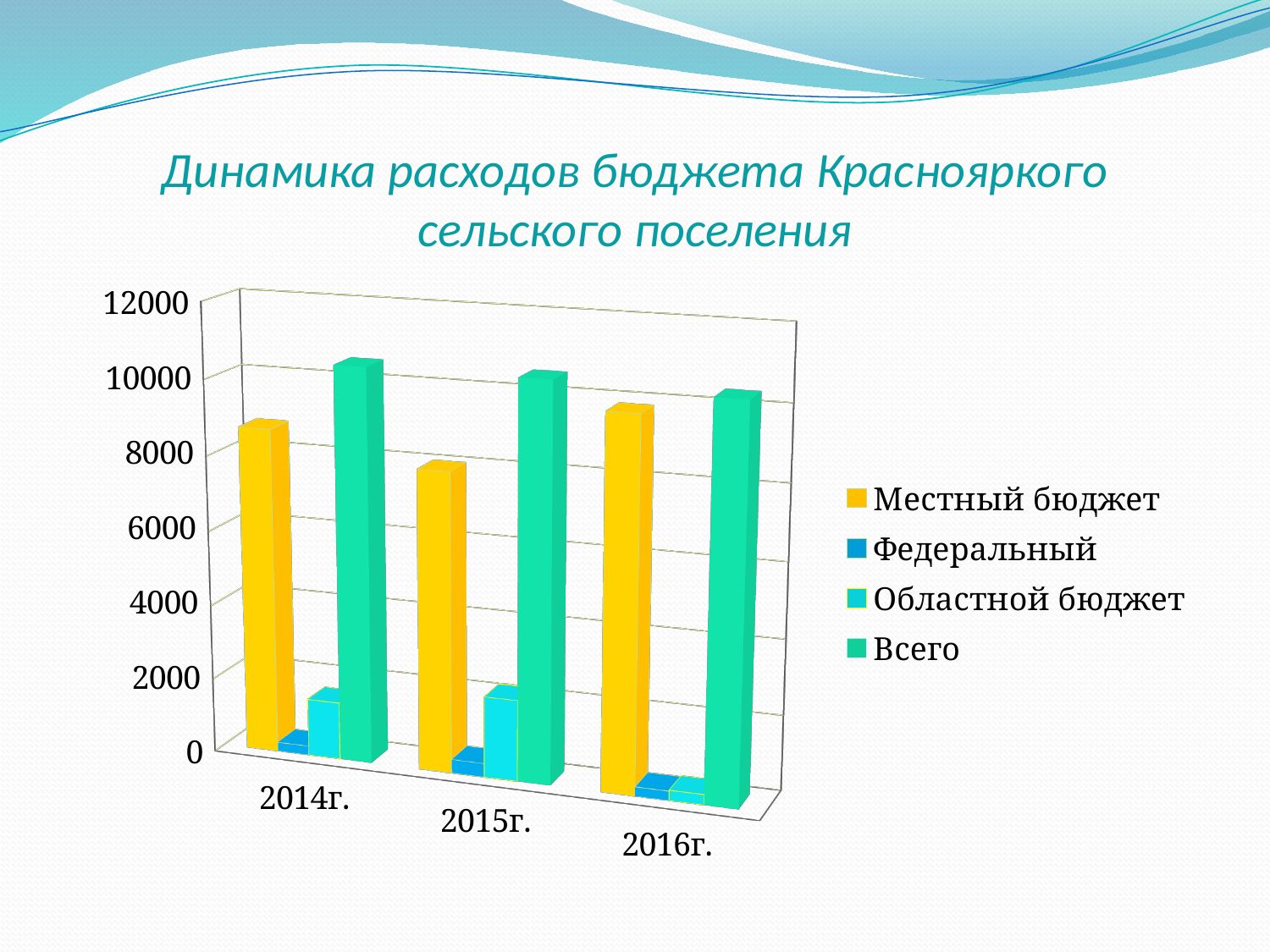
Which year has the lowest value for Всего? 2016г. Is the value for Местный бюджет in 2015г. greater or less than 10000? less Is the value for Всего in 2014г. greater or less than 8000? greater Is the value for Областной бюджет in 2014г. greater or less than 4000? less How many series does the legend list? 4 In 2014г., which is larger: Местный бюджет or Областной бюджет? Местный бюджет Which year has the lowest value for Местный бюджет? 2015г. What is the title of the chart? Динамика расходов бюджета Краснояркого сельского поселения How many years are shown on the x axis? 3 What kind of chart is shown on the slide? bar chart Does the value for Всего rise or fall from 2014г. to 2016г.? fall